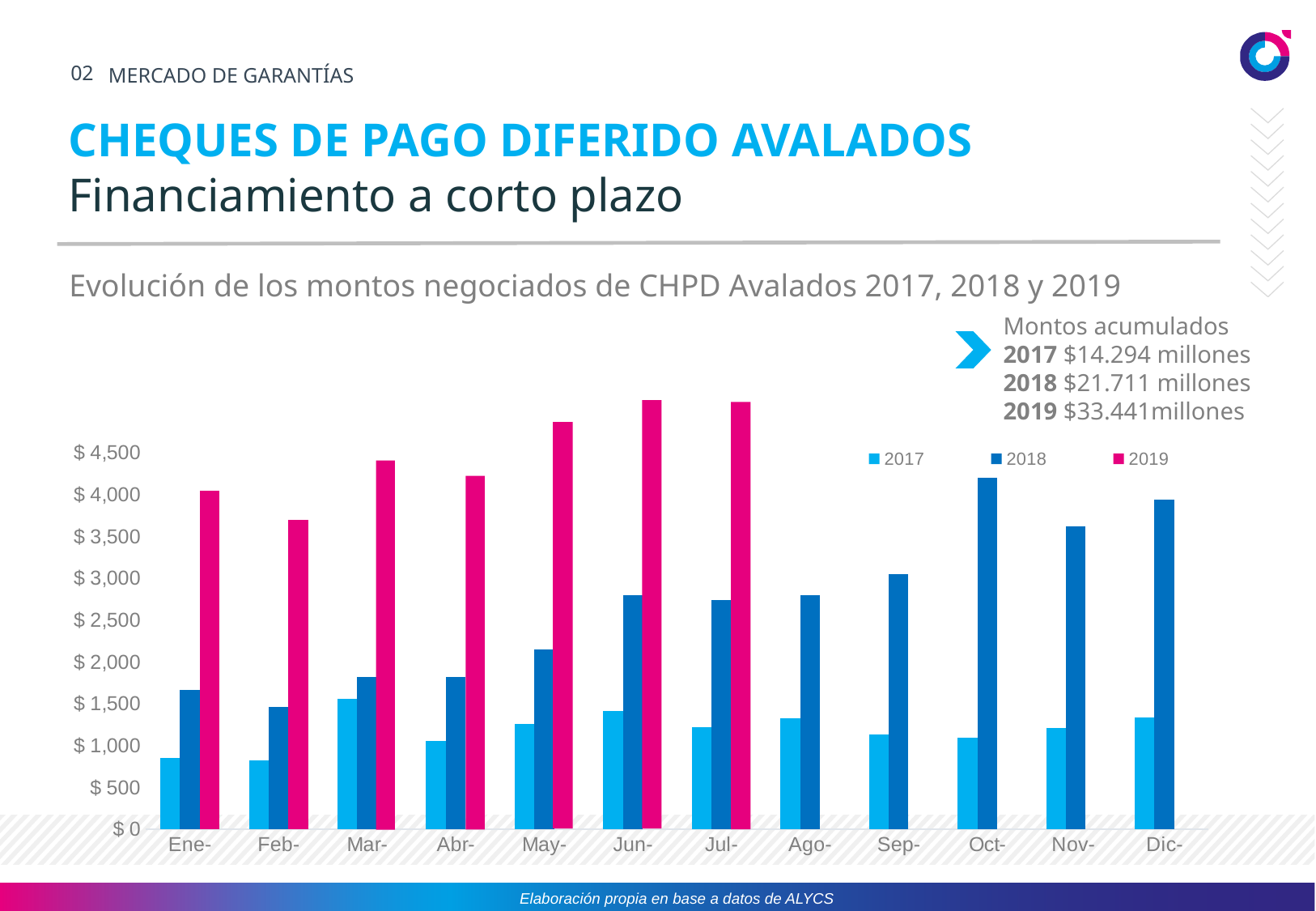
What colour are the bars for the 2019 series? Pink (magenta) Which month has the highest value for the 2018 series? Oct- How many months are shown on the x axis? 12 Which month has the highest value for the 2017 series? Mar- Which is larger, the 2018 value for Oct- or the 2018 value for Dic-? Oct- What kind of chart is shown on the slide? Bar chart Is the value for 2019 in Feb- greater or less than $ 3,500? greater How many series does the legend list? 3 Which month has the lowest value for the 2018 series? Feb- Is the value for 2018 in Oct- greater or less than $ 4,000? greater Is the value for 2017 in Ene- greater or less than $ 1,000? less Which is larger, the 2019 value for Mar- or the 2019 value for Abr-? Mar-